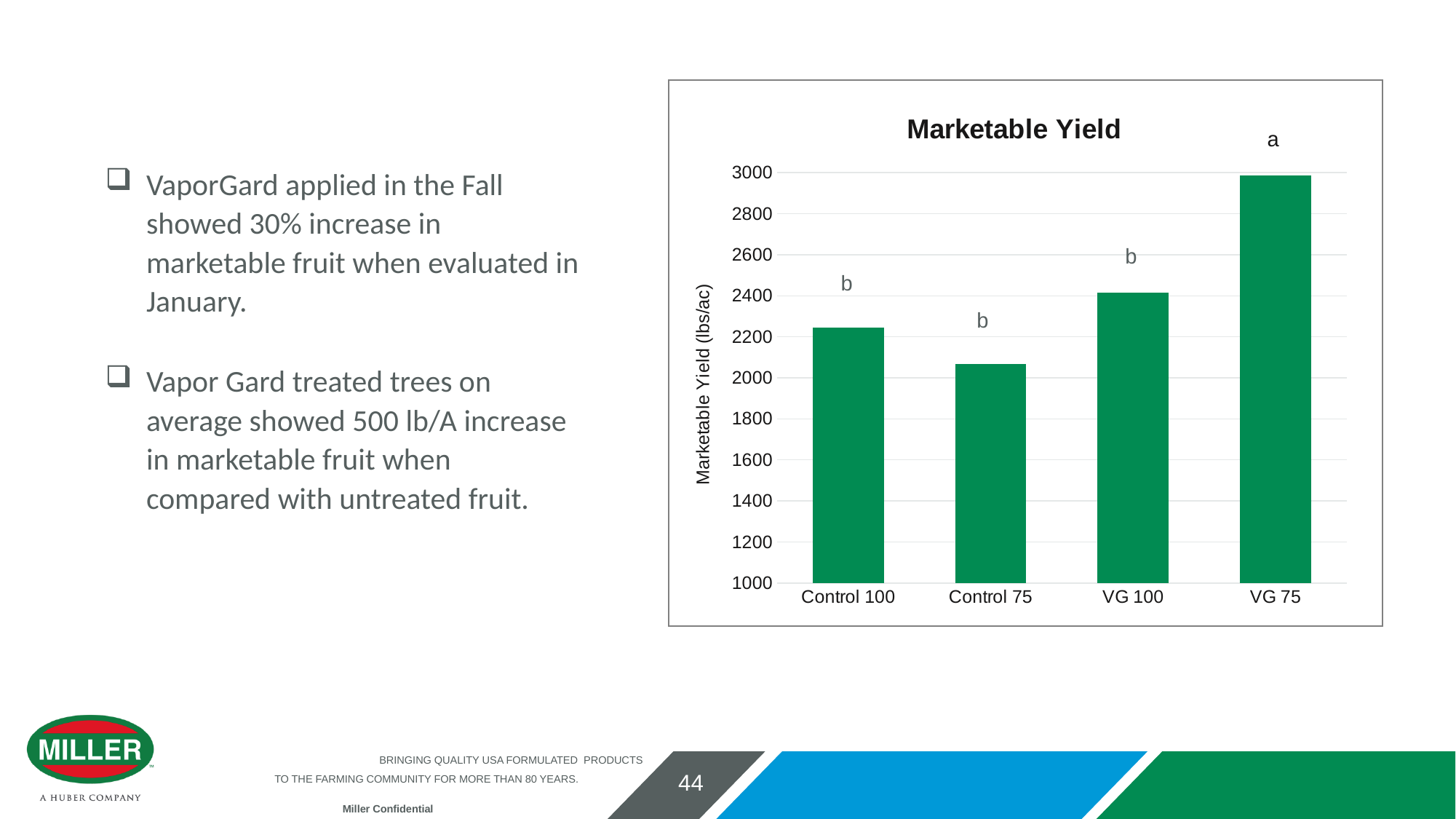
Which category has the lowest marketable yield? Control 75 Is the value for Control 75 greater or less than 2200? less Which category has the highest marketable yield? VG 75 What is the label on the y axis of the chart? Marketable Yield (lbs/ac) Which category is marked with the letter "a" above its bar? VG 75 How many categories are plotted on the x axis of the chart? 4 Is the value for VG 100 greater or less than 2600? less What kind of chart is shown on the slide? bar chart Which has a larger marketable yield, Control 100 or VG 100? VG 100 What is the title of the chart? Marketable Yield Is the value for VG 75 greater or less than 2800? greater Which has a larger marketable yield, Control 75 or Control 100? Control 100